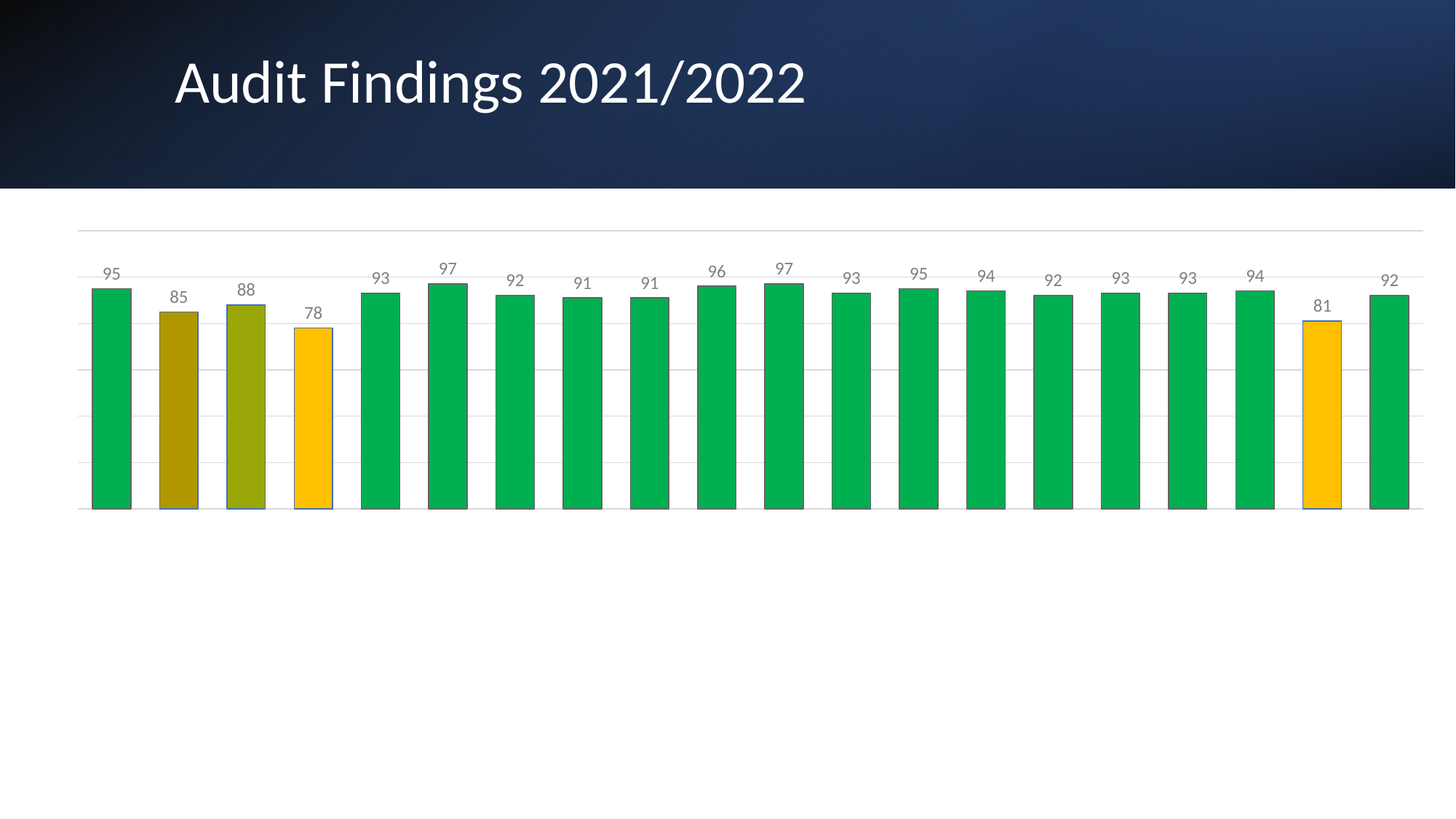
What is the highest value shown in the chart? 97 What is the value of the fourth bar from the left? 78 What is the value of the second bar from the right? 81 What is the value of the last (rightmost) bar? 92 What is the difference between the first bar (95) and the fourth bar (78)? 17 How many bars are plotted in the chart? 20 What is the title of the slide containing the chart? Audit Findings 2021/2022 What kind of chart is shown on the slide? bar chart Which is larger, the second bar from the left or the third bar from the left? the third bar (88) What colour are the two bars with values 78 and 81? yellow What is the lowest value shown in the chart? 78 What is the value of the first (leftmost) bar? 95